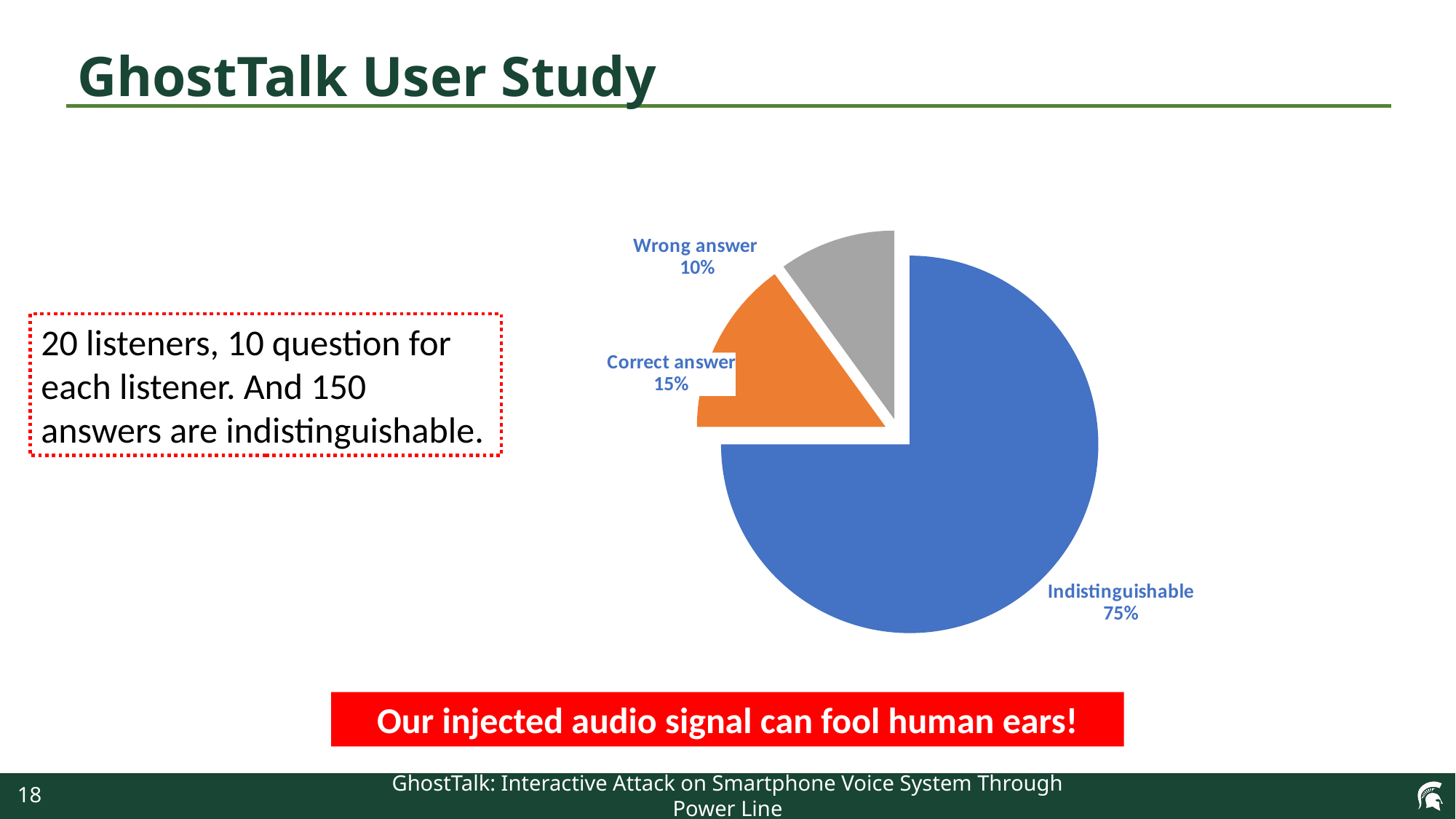
What share of the pie is labelled Correct answer? 15% What is the difference in percentage points between the Indistinguishable slice and the Correct answer slice? 60% How many slices does the pie chart have? 3 Which slice of the pie is the largest? Indistinguishable What share of the pie is labelled Indistinguishable? 75% What colour is the Wrong answer slice? gray Which slice of the pie is the smallest? Wrong answer What share of the pie is labelled Wrong answer? 10% What kind of chart is shown on the slide? pie chart What colour is the Indistinguishable slice? blue Which slice is larger, Correct answer or Wrong answer? Correct answer What is the difference in percentage points between the Correct answer slice and the Wrong answer slice? 5%